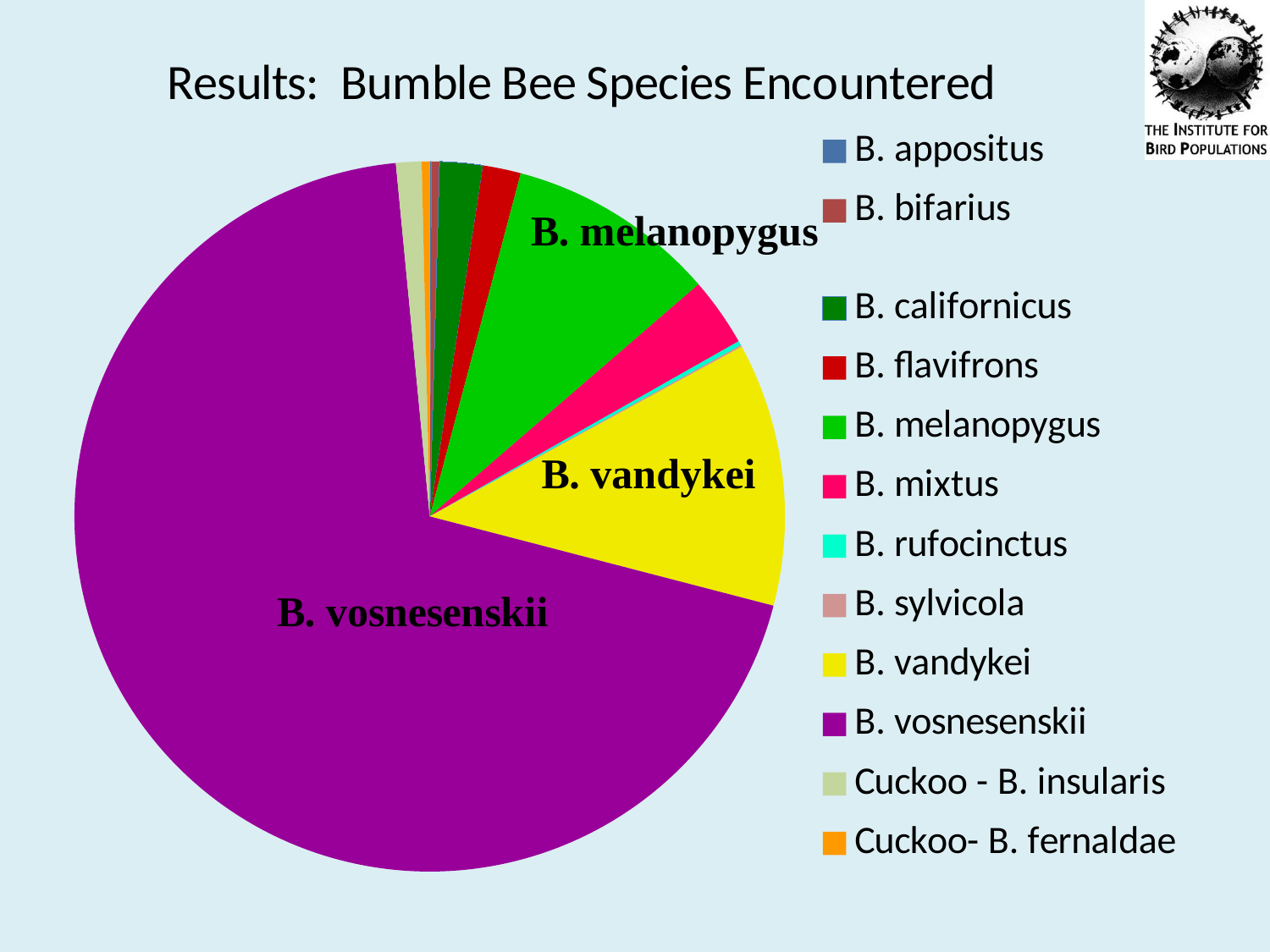
Which bumble bee species has the largest slice of the pie? B. vosnesenskii Which slice is larger, B. flavifrons or B. vosnesenskii? B. vosnesenskii How many data series does the pie chart show? 1 Is the B. vosnesenskii slice more or less than half of the pie? more What kind of chart is shown on the slide? pie chart Which slice is larger, B. melanopygus or B. mixtus? B. melanopygus Which species has the second-largest slice of the pie? B. vandykei What is the title of the slide containing the pie chart? Results: Bumble Bee Species Encountered Which slice is larger, B. vandykei or B. melanopygus? B. vandykei How many species are listed in the legend of the pie chart? 12 What colour is the B. vosnesenskii slice in the pie chart? purple